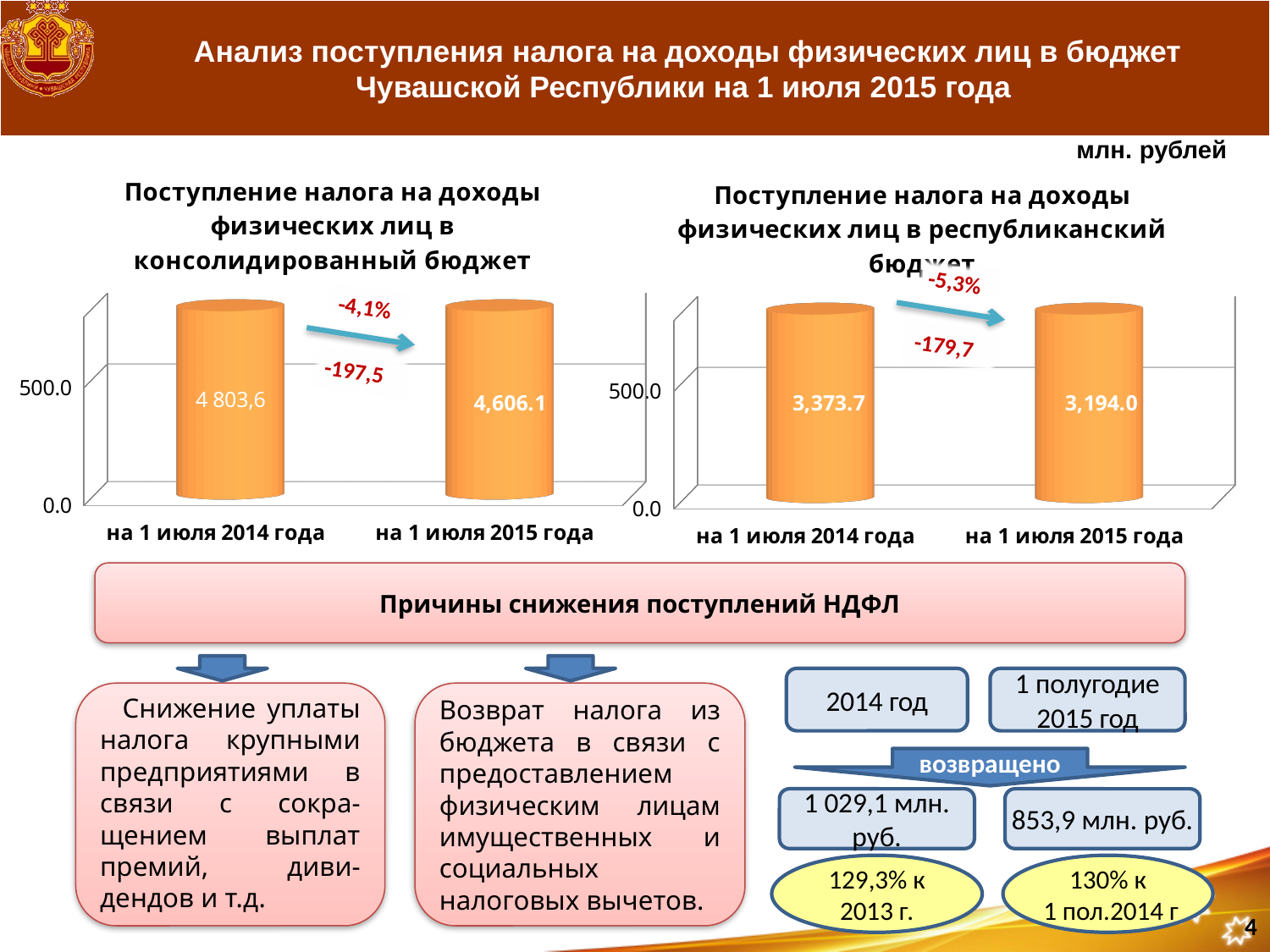
What kind of chart is the right chart (республиканский бюджет)? bar chart On the right chart (республиканский бюджет), which category has the lower value? на 1 июля 2015 года On the left chart (консолидированный бюджет), is the value for 'на 1 июля 2015 года' greater or less than the value for 'на 1 июля 2014 года'? less On the right chart (республиканский бюджет), is the value for 'на 1 июля 2014 года' greater or less than 500.0? greater On the left chart (консолидированный бюджет), which category has the higher value? на 1 июля 2014 года On the right chart (республиканский бюджет), what is the value for 'на 1 июля 2014 года'? 3,373.7 On the right chart (республиканский бюджет), what is the value for 'на 1 июля 2015 года'? 3,194.0 On the left chart (консолидированный бюджет), what is the value for 'на 1 июля 2015 года'? 4,606.1 How many categories are shown on the left chart (консолидированный бюджет)? 2 What percentage change is annotated on the right chart (республиканский бюджет) between 2014 and 2015? -5,3% On the left chart (консолидированный бюджет), what is the value for 'на 1 июля 2014 года'? 4 803,6 On the right chart (республиканский бюджет), what is the difference between the 2014 and 2015 values? 179.7